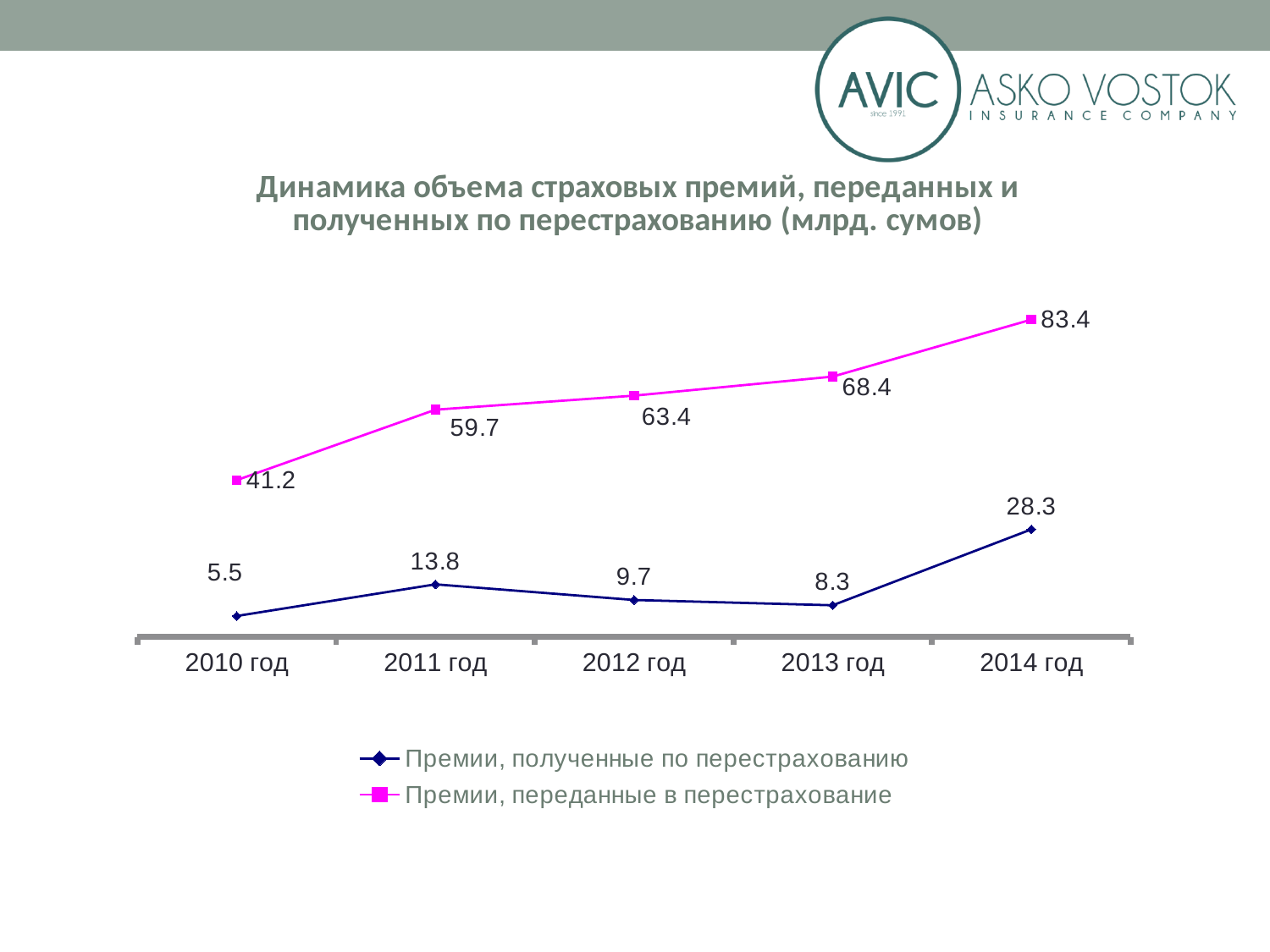
In which year is 'Премии, полученные по перестрахованию' lowest? 2010 год What is the value for 'Премии, переданные в перестрахование' in 2010 год? 41.2 Does 'Премии, переданные в перестрахование' rise or fall from 2010 год to 2014 год? Rise Which is larger for 'Премии, полученные по перестрахованию': the value in 2012 год or in 2013 год? 2012 год What is the difference between the 2013 год and 2012 год values for 'Премии, переданные в перестрахование'? 5.0 How many years are shown on the x axis? 5 In which year is 'Премии, переданные в перестрахование' highest? 2014 год How many series does the legend list? 2 What is the value for 'Премии, полученные по перестрахованию' in 2011 год? 13.8 What is the difference between 'Премии, переданные в перестрахование' and 'Премии, полученные по перестрахованию' in 2014 год? 55.1 What kind of chart is shown on the slide? Line chart What is the value for 'Премии, переданные в перестрахование' in 2014 год? 83.4